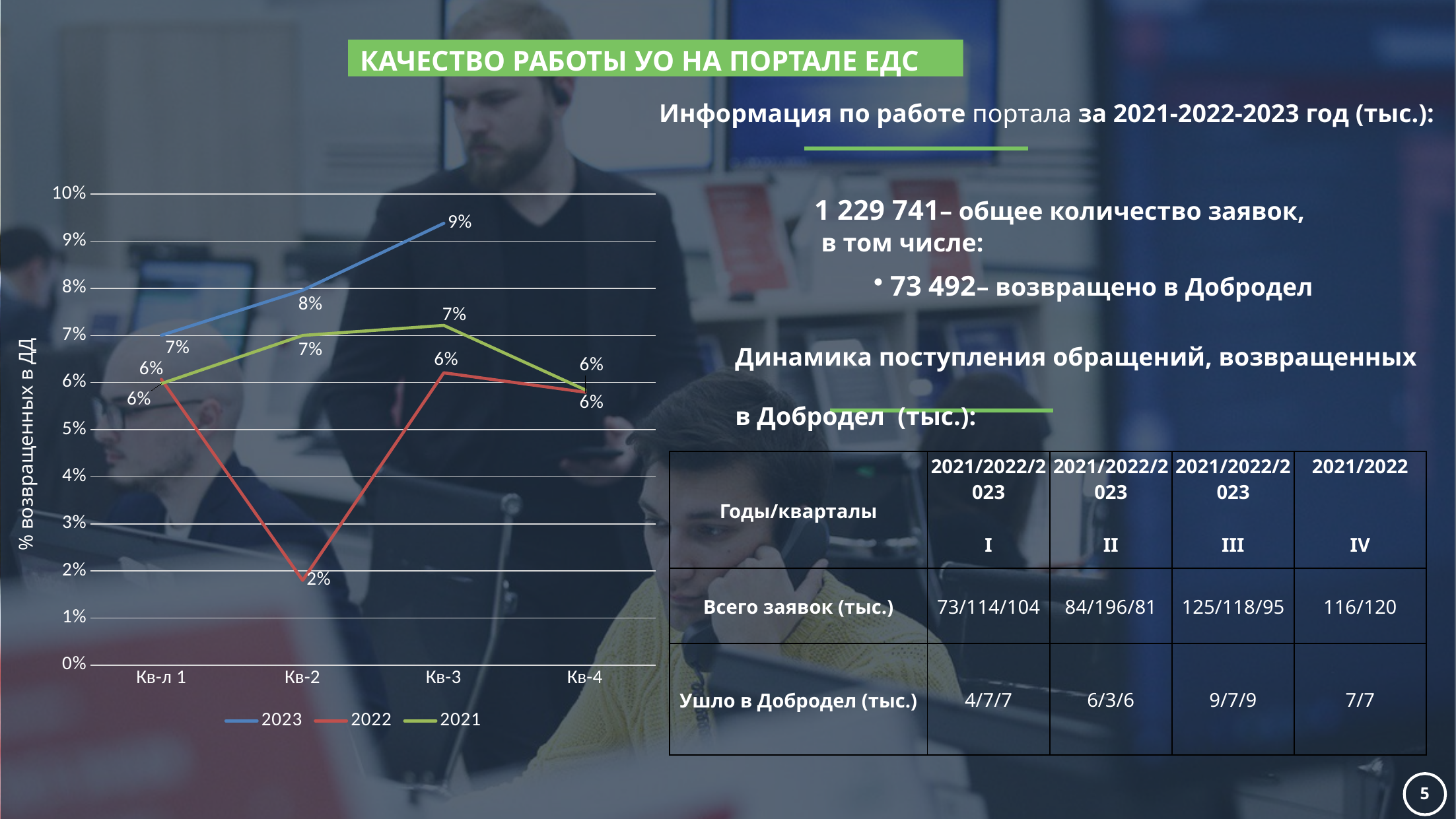
What is the difference between the 2023 value and the 2022 value at Кв-3? 3% In which quarter is the 2022 series at its lowest? Кв-2 How many quarters are shown on the x axis? 4 At Кв-2, which series has the larger value, 2023 or 2022? 2023 What is the value for the 2023 series at Кв-3? 9% What is the value for the 2023 series at Кв-л 1? 7% What kind of chart is shown on the slide? line chart In which quarter is the 2023 series at its highest? Кв-3 Does the 2023 series rise or fall from Кв-л 1 to Кв-3? rises What is the value for the 2022 series at Кв-2? 2% How many series does the legend list? 3 What is the value for the 2021 series at Кв-3? 7%